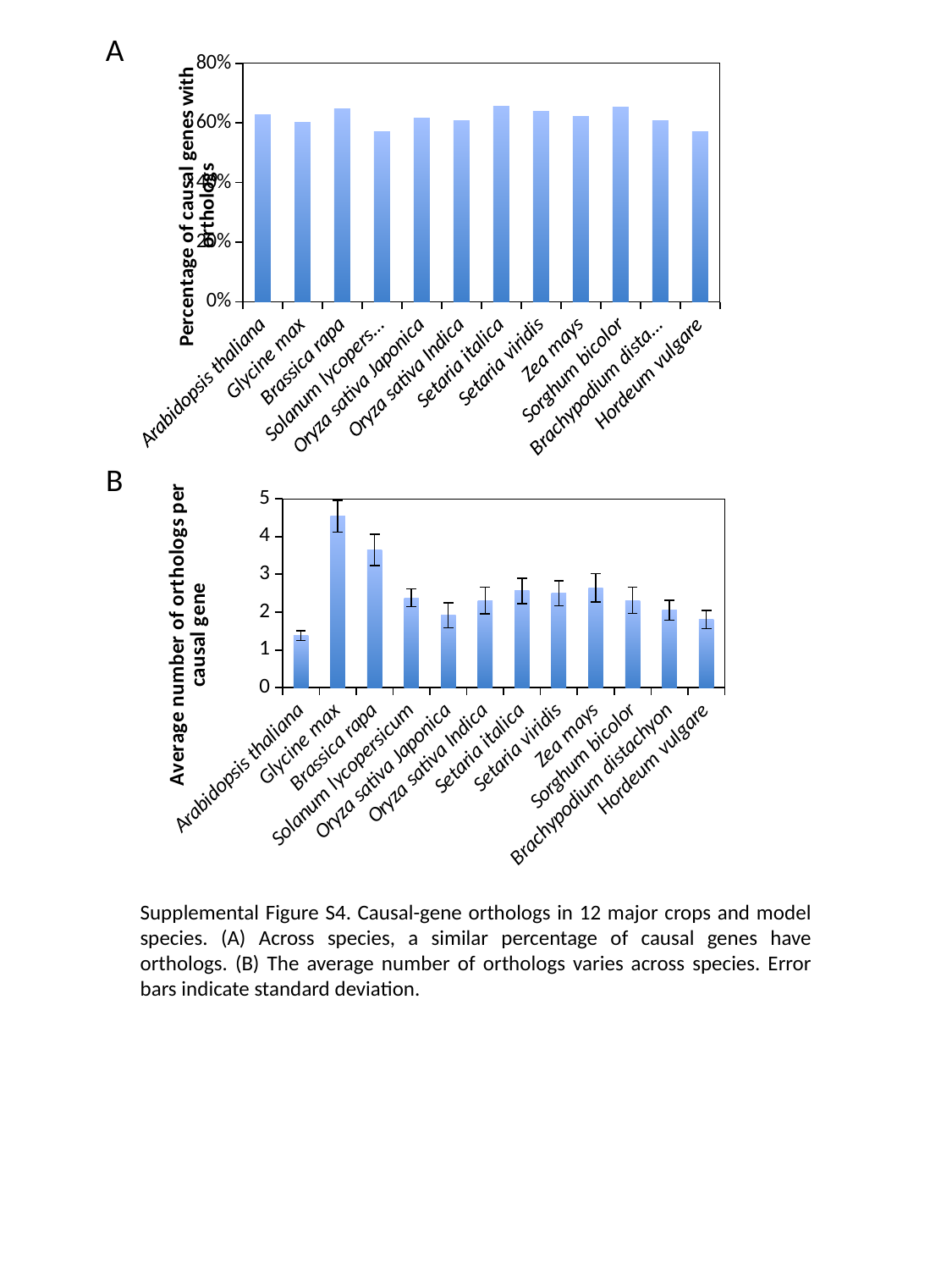
In chart B (Average number of orthologs per causal gene), which species has the highest value? Glycine max In chart A (Percentage of causal genes with orthologs), is the value for Hordeum vulgare greater or less than 60%? less In chart A (Percentage of causal genes with orthologs), is the value for Setaria italica greater or less than 60%? greater In chart B (Average number of orthologs per causal gene), which species has the lowest value? Arabidopsis thaliana In chart B (Average number of orthologs per causal gene), which is larger, the value for Glycine max or the value for Brassica rapa? Glycine max In chart B (Average number of orthologs per causal gene), is the value for Hordeum vulgare greater or less than 2? less In chart A (Percentage of causal genes with orthologs), how many species are plotted? 12 According to the caption, what do the error bars in chart B indicate? Standard deviation What kind of chart is chart A? bar chart